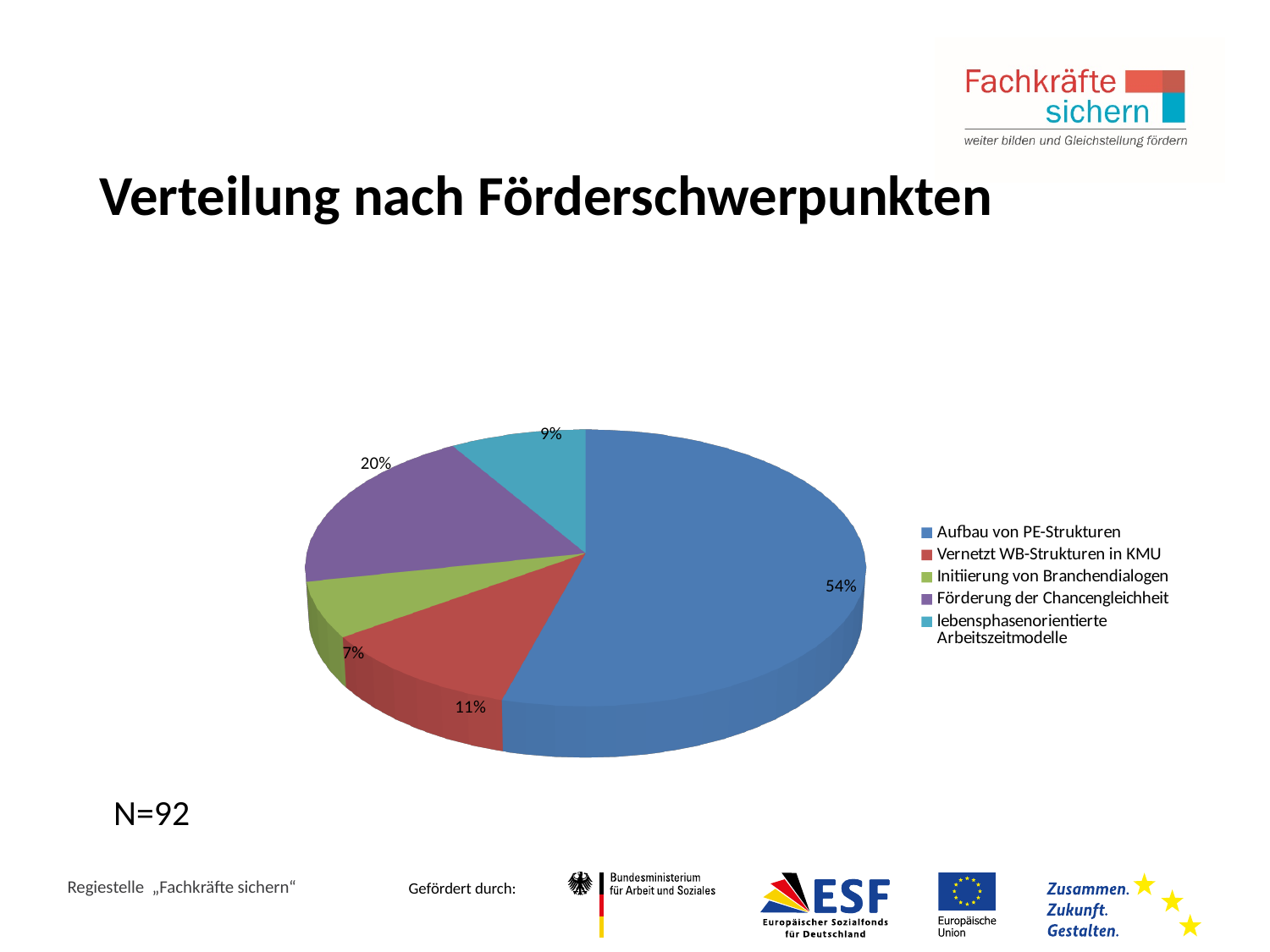
Which category has the largest slice of the pie? Aufbau von PE-Strukturen What is the title of the chart on the slide? Verteilung nach Förderschwerpunkten What kind of chart is shown on the slide? Pie chart What share of the pie does Aufbau von PE-Strukturen have? 54% Which is larger, the share for Vernetzt WB-Strukturen in KMU or the share for lebensphasenorientierte Arbeitszeitmodelle? Vernetzt WB-Strukturen in KMU What share of the pie does lebensphasenorientierte Arbeitszeitmodelle have? 9% How many categories does the pie chart show? 5 What is the difference in percentage points between Aufbau von PE-Strukturen and Förderung der Chancengleichheit? 34 percentage points What share of the pie does Vernetzt WB-Strukturen in KMU have? 11% Which category has the smallest slice of the pie? Initiierung von Branchendialogen